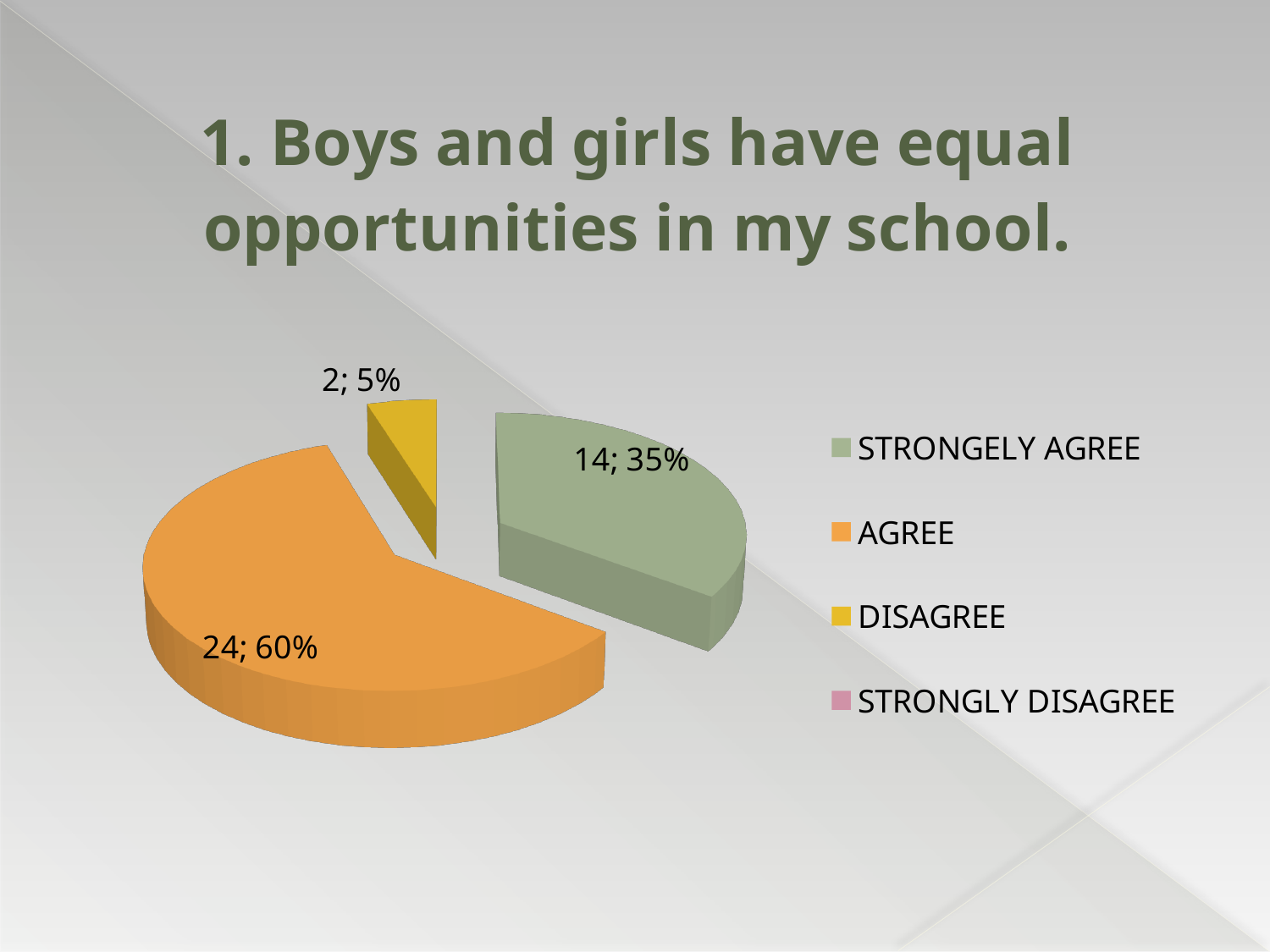
What is the count shown for the DISAGREE slice? 2 Which is larger, the STRONGELY AGREE slice or the DISAGREE slice? STRONGELY AGREE What is the difference in count between the AGREE and STRONGELY AGREE slices? 10 Which labelled slice is the smallest? DISAGREE What share of the pie does the AGREE slice represent? 60% How many entries does the legend list? 4 Which category has the largest slice of the pie? AGREE What percentage is shown for the STRONGELY AGREE slice? 35% What kind of chart is shown on the slide? pie chart What colour is the AGREE slice in the pie chart? orange What is the count shown for the AGREE slice? 24 What share of the pie does the DISAGREE slice represent? 5%